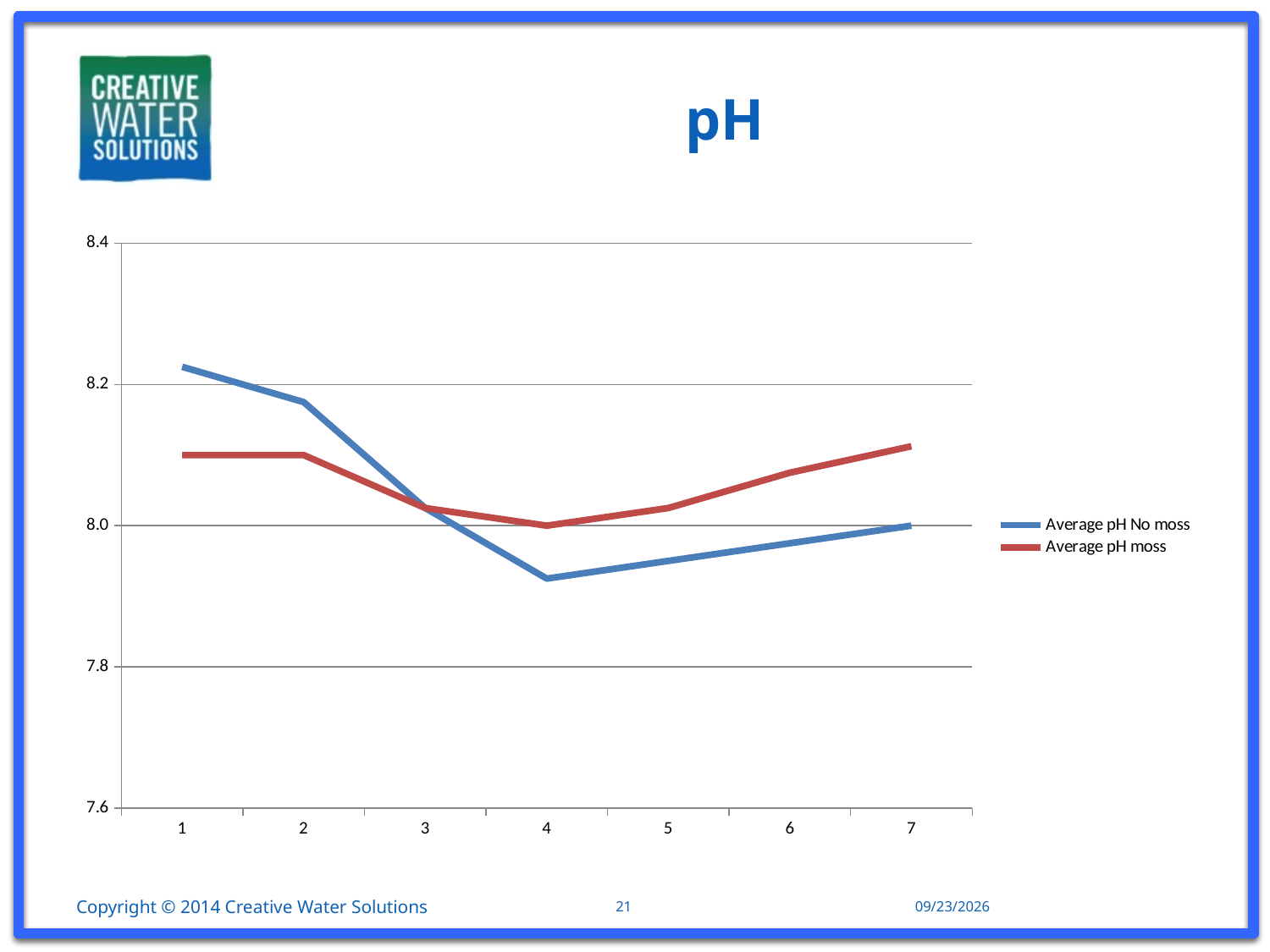
At point 6, which series has the higher value, Average pH No moss or Average pH moss? Average pH moss At which x-axis point is the Average pH No moss series highest? 1 At which x-axis point is the Average pH moss series lowest? 4 At which x-axis point is the Average pH No moss series lowest? 4 How many points are plotted along the x axis for each series? 7 Is the value for Average pH No moss at point 4 greater or less than 8.0? less At point 1, which series has the higher value, Average pH No moss or Average pH moss? Average pH No moss What kind of chart is shown on the slide? Line chart At which x-axis point is the Average pH moss series highest? 7 How many series does the legend list? 2 Is the value for Average pH No moss at point 1 greater or less than 8.2? greater Does the Average pH No moss series rise or fall from point 1 to point 4? Fall